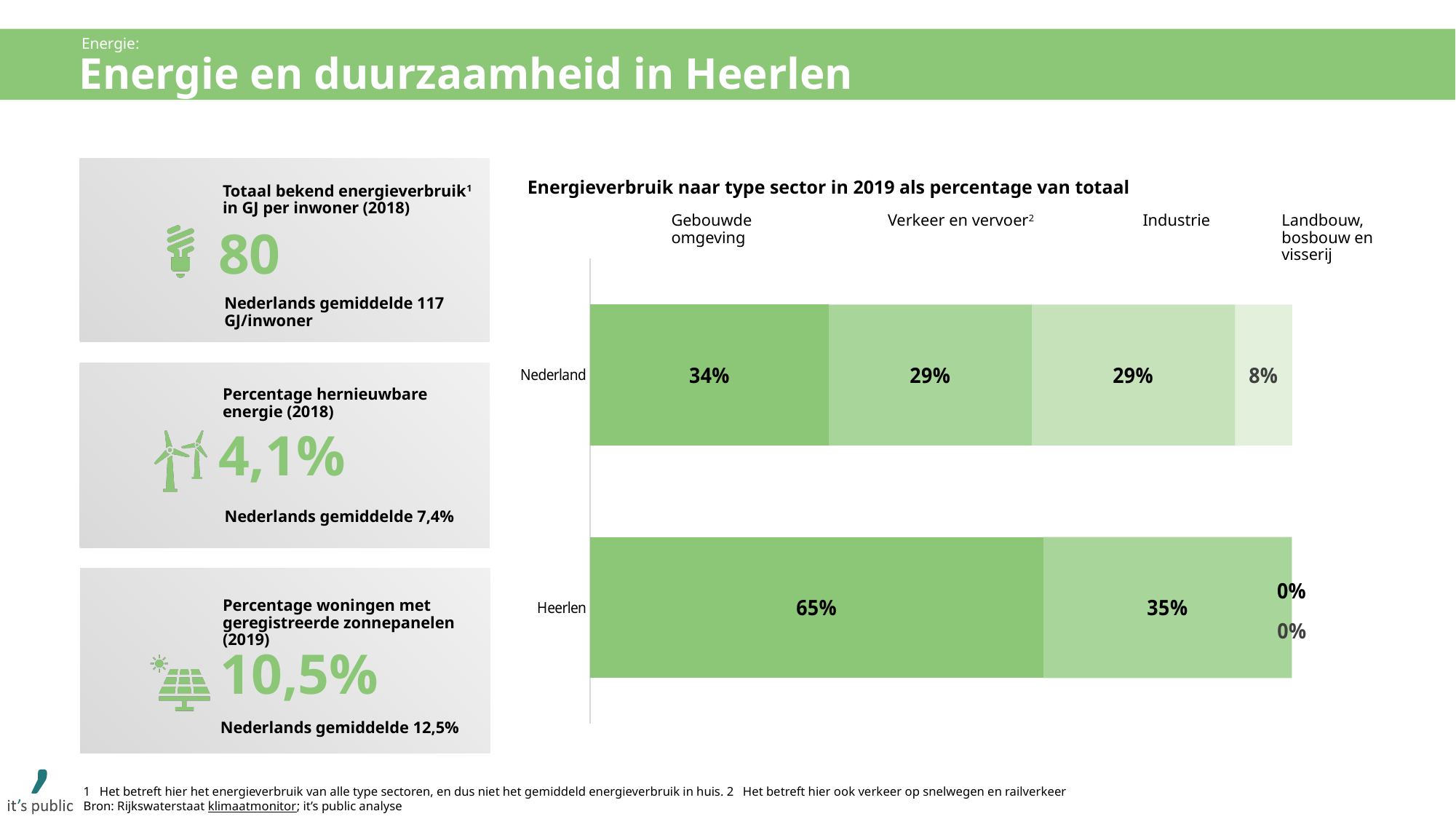
What is the value for Industrie for Heerlen? 0% What is the value for Gebouwde omgeving for Heerlen? 65% What is the value for Landbouw, bosbouw en visserij for Nederland? 8% What is the value for Gebouwde omgeving for Nederland? 34% What kind of chart is shown on the slide? Stacked bar chart What is the difference between the Gebouwde omgeving share for Heerlen and for Nederland? 31% What is the title of the chart? Energieverbruik naar type sector in 2019 als percentage van totaal Which sector has the lowest share for Nederland? Landbouw, bosbouw en visserij Which sector has the highest share for Nederland? Gebouwde omgeving How many sectors (series) does the chart show? 4 What is the value for Verkeer en vervoer for Heerlen? 35% Which is larger: the Verkeer en vervoer share for Heerlen or for Nederland? Heerlen